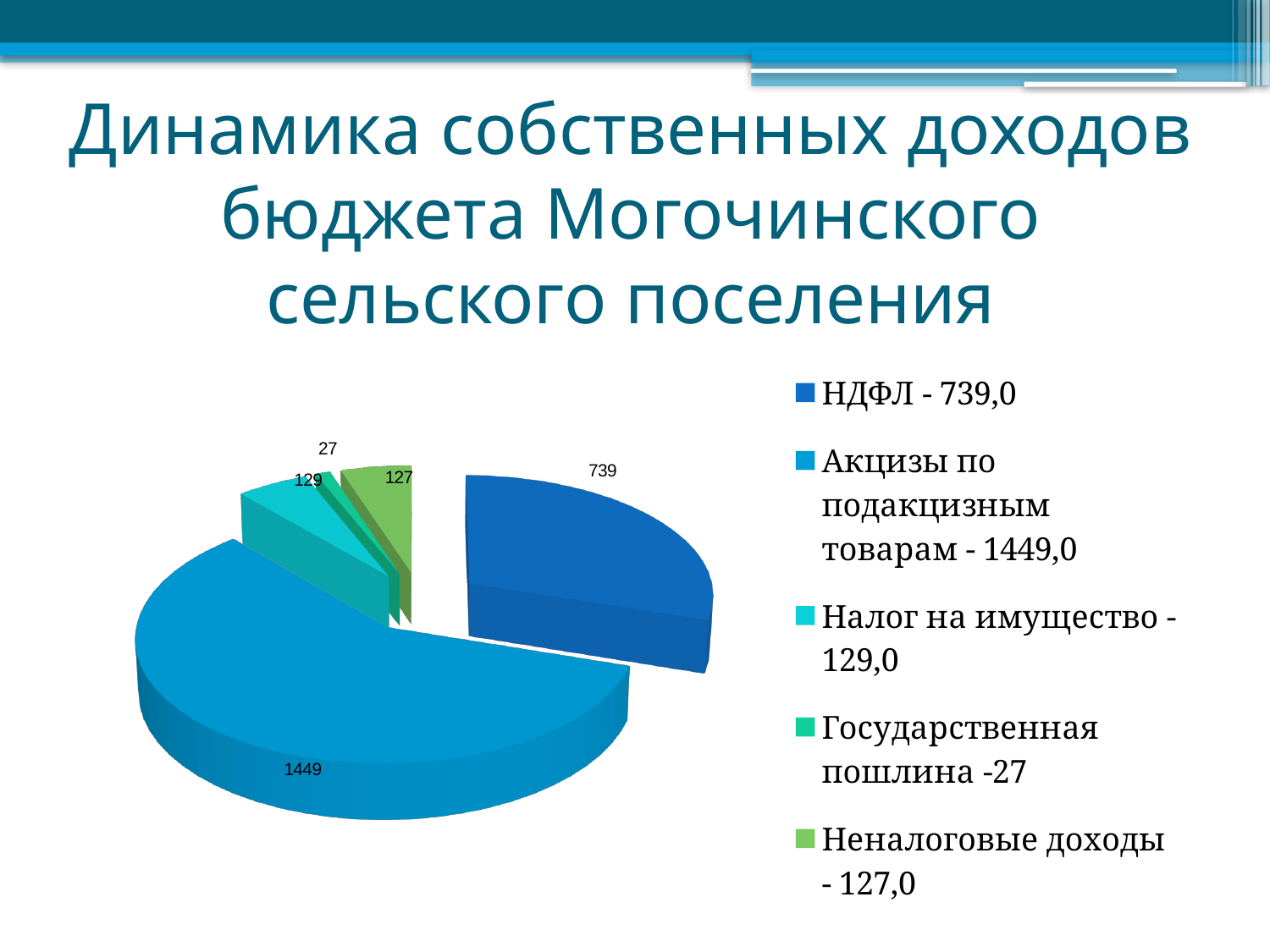
What is the value of the Государственная пошлина slice? 27 What is the value of the Акцизы по подакцизным товарам slice? 1449 Which is larger, the НДФЛ slice or the Налог на имущество slice? НДФЛ What is the title of the slide containing the pie chart? Динамика собственных доходов бюджета Могочинского сельского поселения How many categories does the legend of the pie chart list? 5 What is the value of the Налог на имущество slice? 129 What is the value of the НДФЛ slice in the pie chart? 739 Which category has the largest slice in the pie chart? Акцизы по подакцизным товарам What is the difference between the Акцизы по подакцизным товарам value and the НДФЛ value? 710 What kind of chart is shown on the slide? pie chart Which category has the smallest slice in the pie chart? Государственная пошлина What is the value of the Неналоговые доходы slice? 127